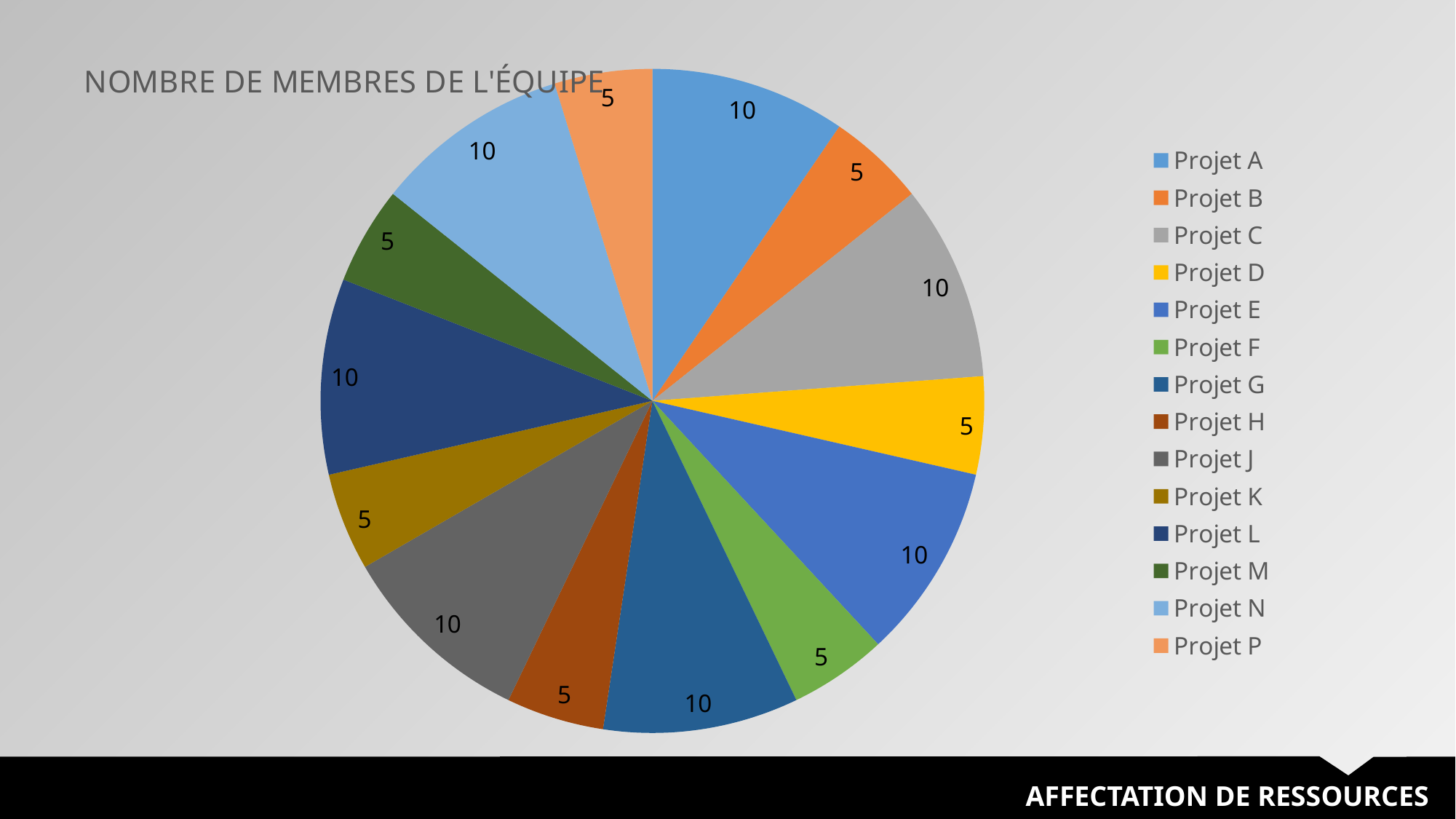
What is the difference between the value for Projet A and the value for Projet B? 5 Which is larger, the value for Projet C or the value for Projet D? Projet C What is the value for Projet D? 5 What type of chart is shown on the slide? pie chart How many slices (projects) does the pie chart have? 14 What is the value for Projet P? 5 What is the value for Projet L? 10 What is the largest slice value shown in the chart? 10 What is the value for Projet B? 5 What is the smallest slice value shown in the chart? 5 What is the value for Projet A? 10 What is the title of the chart? NOMBRE DE MEMBRES DE L'ÉQUIPE